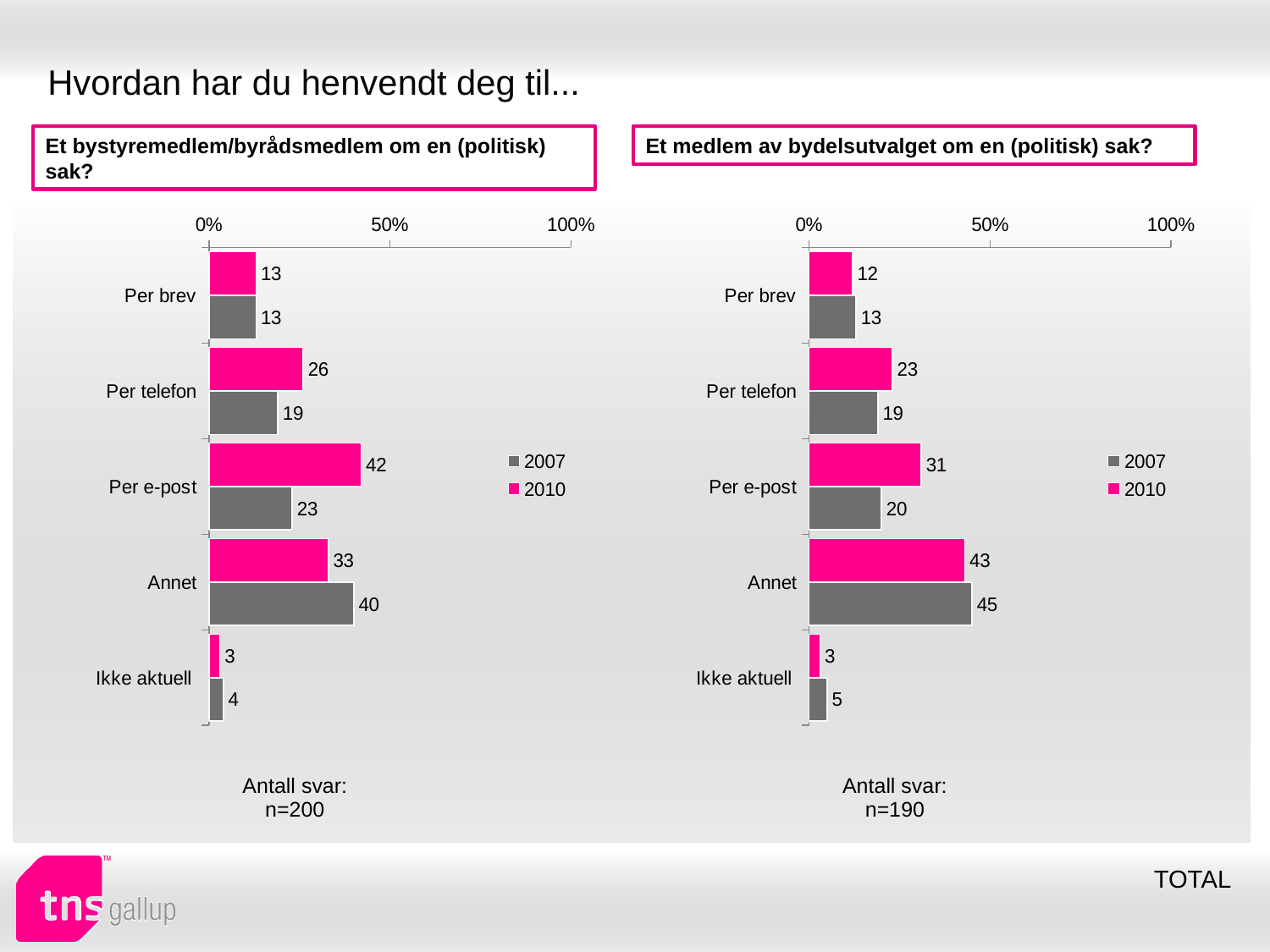
In the left chart (Et bystyremedlem/byrådsmedlem om en (politisk) sak?), what is the 2010 value for Per e-post? 42 In the right chart, which is larger for Per telefon: the 2007 value or the 2010 value? 2010 In the left chart, which category has the highest 2007 value? Annet What type of chart is used on the left side of the slide? Bar chart In the right chart (Et medlem av bydelsutvalget om en (politisk) sak?), what is the 2007 value for Annet? 45 In the left chart, is the 2007 value for Annet greater or less than 50%? less In the left chart, what is the difference between the 2010 and 2007 values for Per e-post? 19 In the right chart, which category has the lowest 2010 value? Ikke aktuell In the right chart, what is the difference between the 2010 and 2007 values for Per e-post? 11 How many series does the legend of the left chart list? 2 How many categories are shown in the right chart? 5 What is the number of respondents (Antall svar) stated under the right chart? n=190